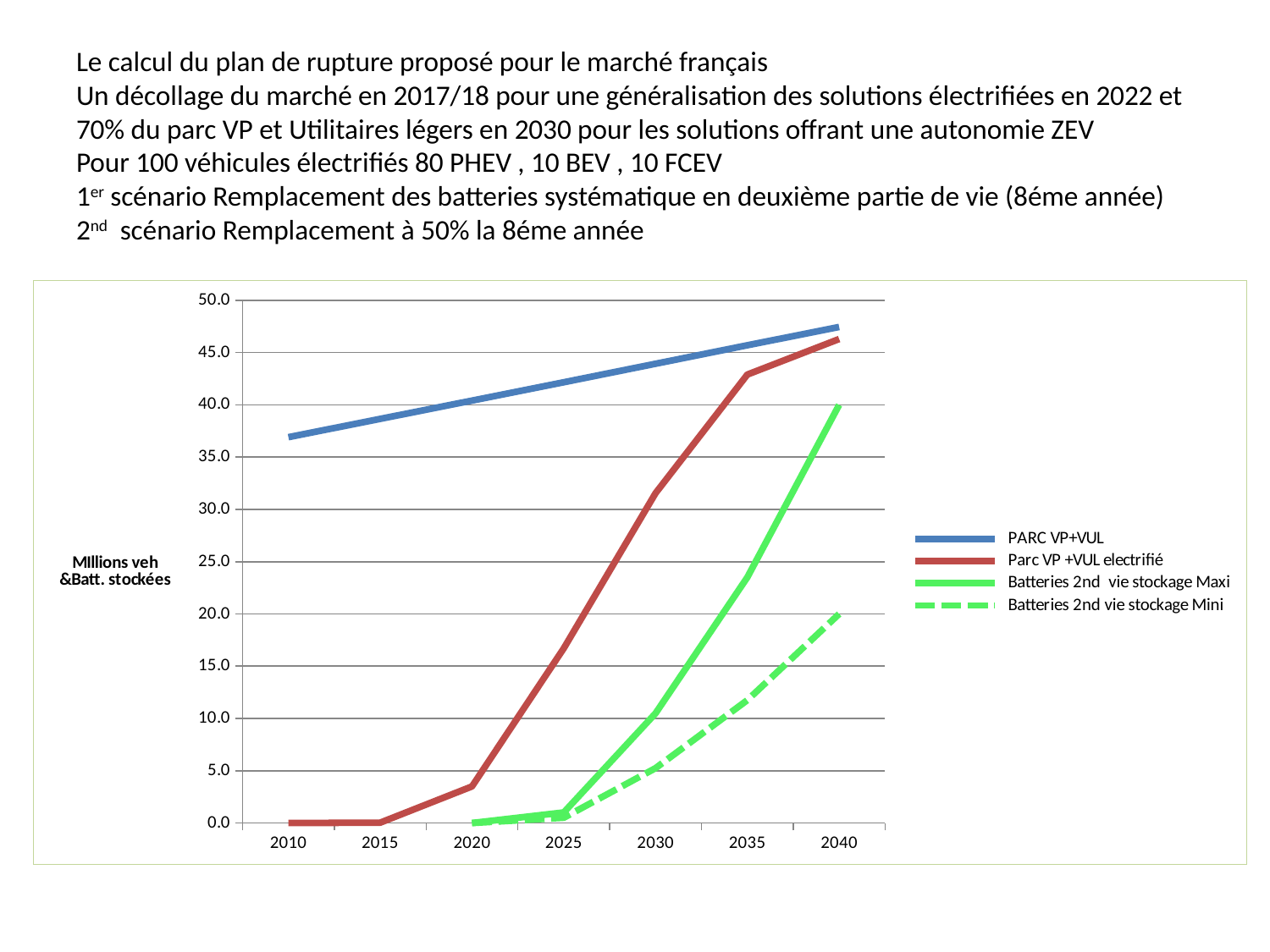
Is the value for Batteries 2nd vie stockage Maxi in 2040 greater or less than 35.0? greater How many years are marked on the x axis? 7 Is the value for Batteries 2nd vie stockage Mini in 2040 greater or less than 25.0? less How many series does the legend list? 4 Does the PARC VP+VUL series rise or fall from 2010 to 2040? rise What is the value of Parc VP +VUL electrifié in 2010? 0.0 Which series is drawn with a dashed line? Batteries 2nd vie stockage Mini In 2040, which is larger: Batteries 2nd vie stockage Maxi or Batteries 2nd vie stockage Mini? Batteries 2nd vie stockage Maxi What kind of chart is shown on the slide? line chart Is the value for Parc VP +VUL electrifié in 2020 greater or less than 5.0? less Which series has the lowest value in 2040? Batteries 2nd vie stockage Mini